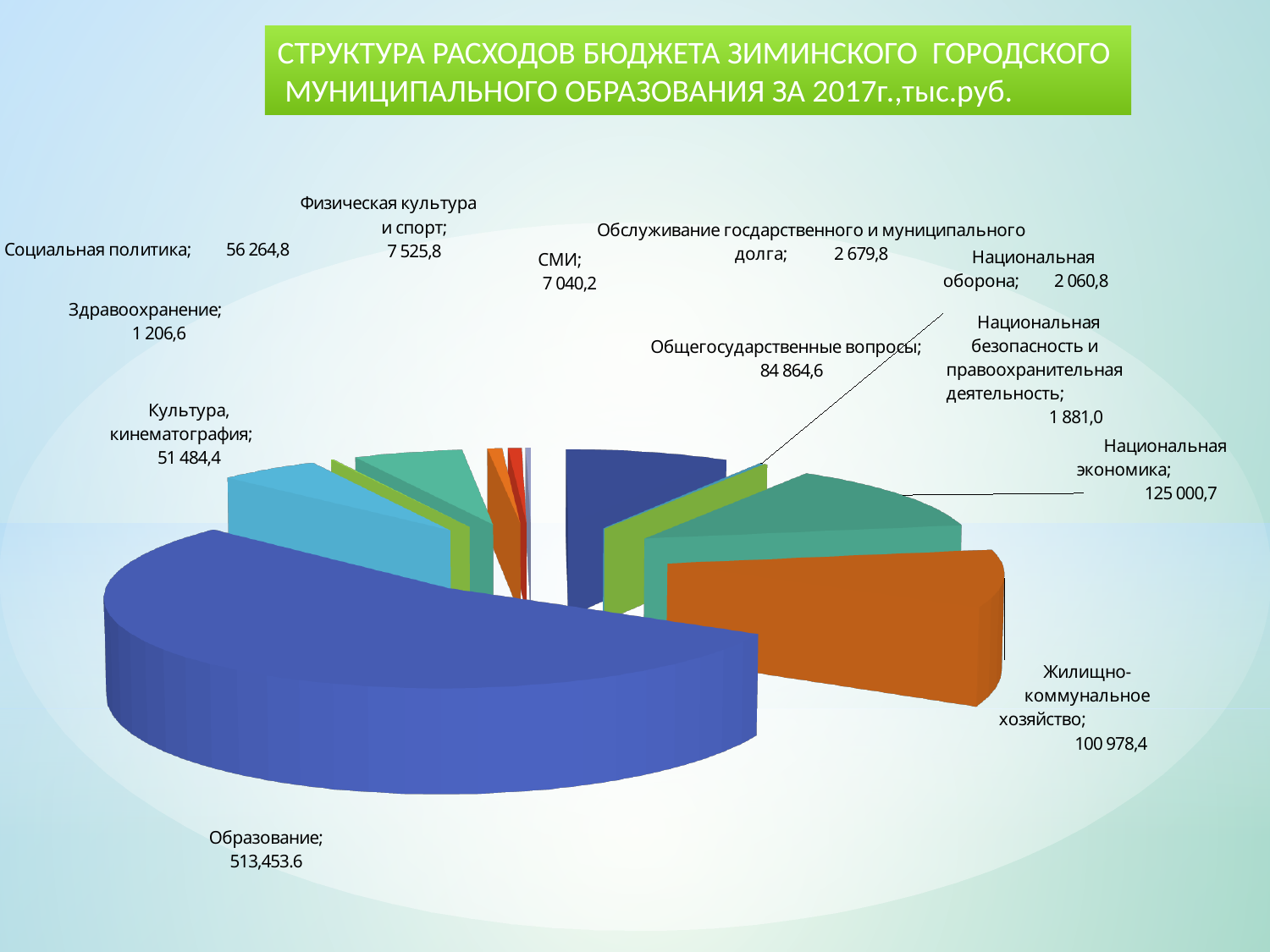
Which category has the largest value? Образование What year does the chart title say the budget expenditure structure is for? 2017 Which category has the smallest value? Здравоохранение What is the value for Национальная экономика? 125 000,7 What is the value for Жилищно-коммунальное хозяйство? 100 978,4 Which is larger, Общегосударственные вопросы or Социальная политика? Общегосударственные вопросы What is the difference between Национальная экономика and Жилищно-коммунальное хозяйство? 24 022,3 What is the value for Образование? 513,453.6 What is the value for Национальная оборона? 2 060,8 What kind of chart is shown on the slide? pie chart How many categories does the pie chart show? 12 What is the value for Культура, кинематография? 51 484,4